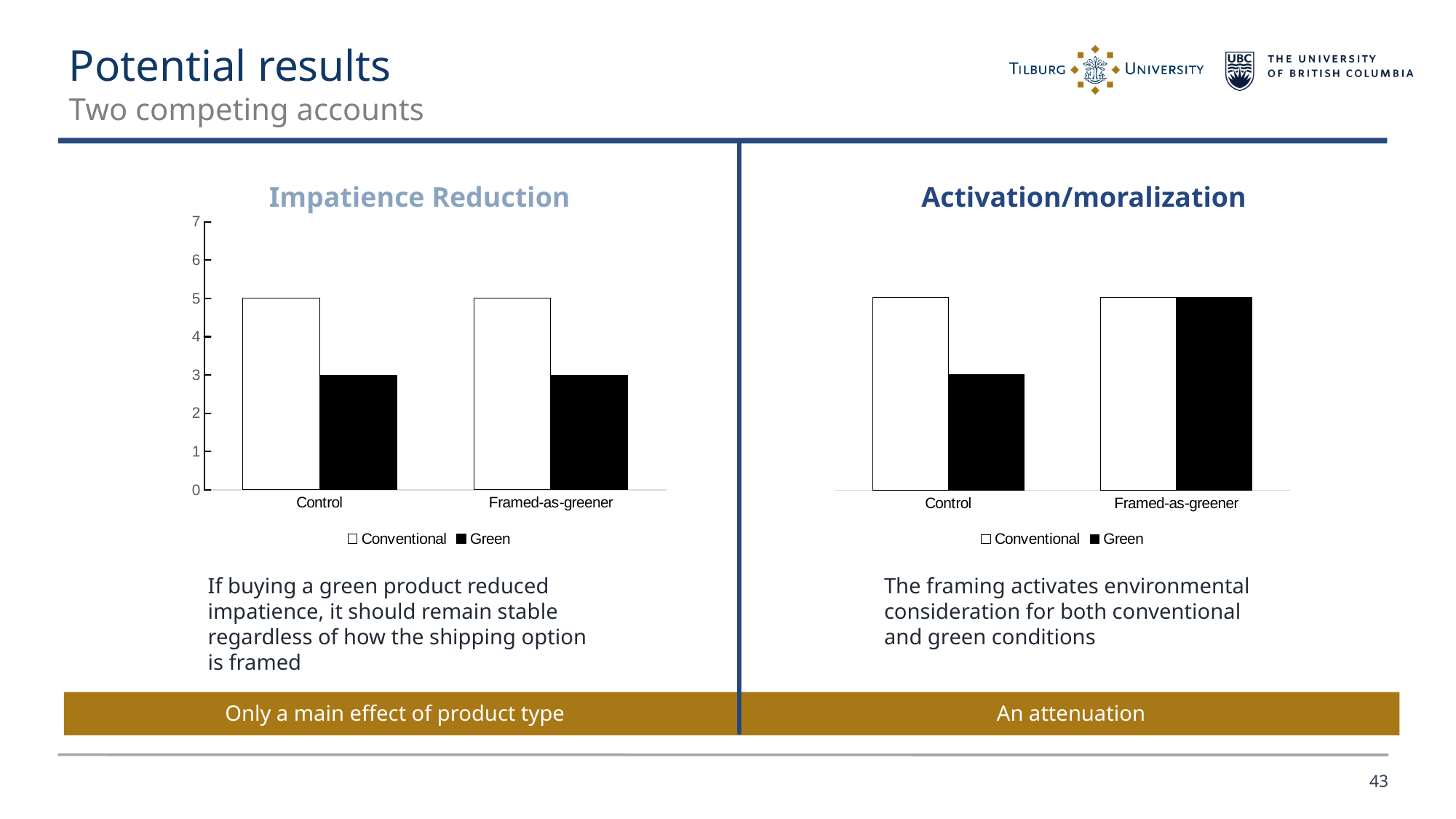
In the Impatience Reduction chart, what is the difference between the Conventional and Green values in the Control condition? 2 In the Activation/moralization chart, how many series does the legend list? 2 In the Impatience Reduction chart, what is the value for Conventional in the Control condition? 5 What kind of chart is the Impatience Reduction chart? Bar chart What is the title of the chart on the right side of the slide? Activation/moralization In the Impatience Reduction chart, what is the value for Green in the Framed-as-greener condition? 3 In the Impatience Reduction chart, how many categories are shown on the x axis? 2 In the Activation/moralization chart, which colour represents the Green series? Black In the Impatience Reduction chart, is the Green value in the Control condition greater or less than 4? less In the Activation/moralization chart, which series has the larger value in the Control condition, Conventional or Green? Conventional In the Activation/moralization chart, does the Green value rise or fall from Control to Framed-as-greener? Rise In the Impatience Reduction chart, how many series does the legend list? 2